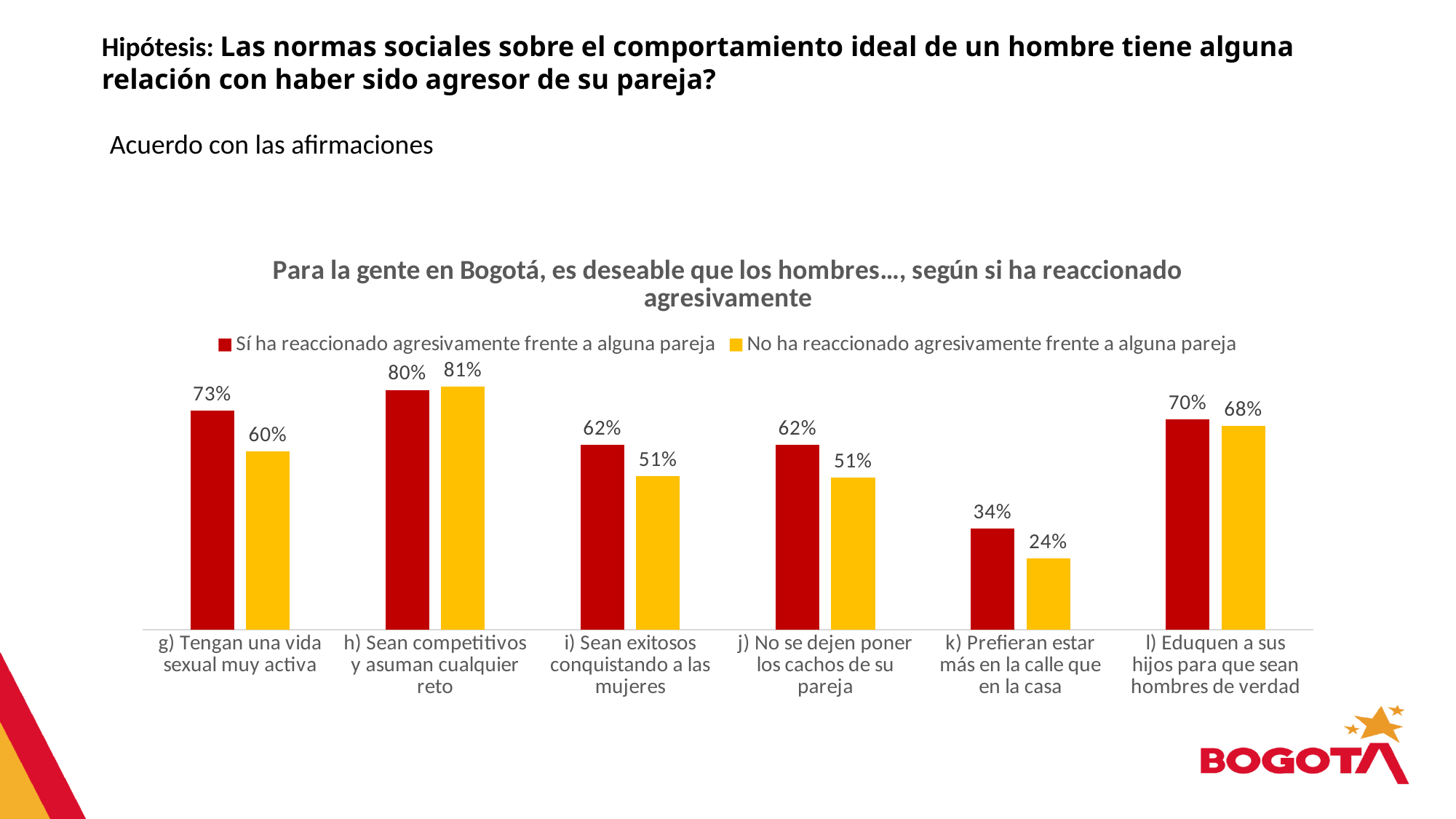
For category l) Eduquen a sus hijos para que sean hombres de verdad, which series has the larger value? Sí ha reaccionado agresivamente frente a alguna pareja What is the value for "No ha reaccionado agresivamente frente a alguna pareja" for category k) Prefieran estar más en la calle que en la casa? 24% What colour represents the series "No ha reaccionado agresivamente frente a alguna pareja"? Yellow Which category has the highest value for "Sí ha reaccionado agresivamente frente a alguna pareja"? h) Sean competitivos y asuman cualquier reto What kind of chart is shown on the slide? Bar chart What is the difference between the two series for category i) Sean exitosos conquistando a las mujeres? 11 percentage points Which category has the lowest value for "No ha reaccionado agresivamente frente a alguna pareja"? k) Prefieran estar más en la calle que en la casa What is the value for "No ha reaccionado agresivamente frente a alguna pareja" for category h) Sean competitivos y asuman cualquier reto? 81% How many series does the legend list? 2 How many categories are shown on the x axis? 6 What is the value for "Sí ha reaccionado agresivamente frente a alguna pareja" for category g) Tengan una vida sexual muy activa? 73% What is the difference between the two series for category g) Tengan una vida sexual muy activa? 13 percentage points